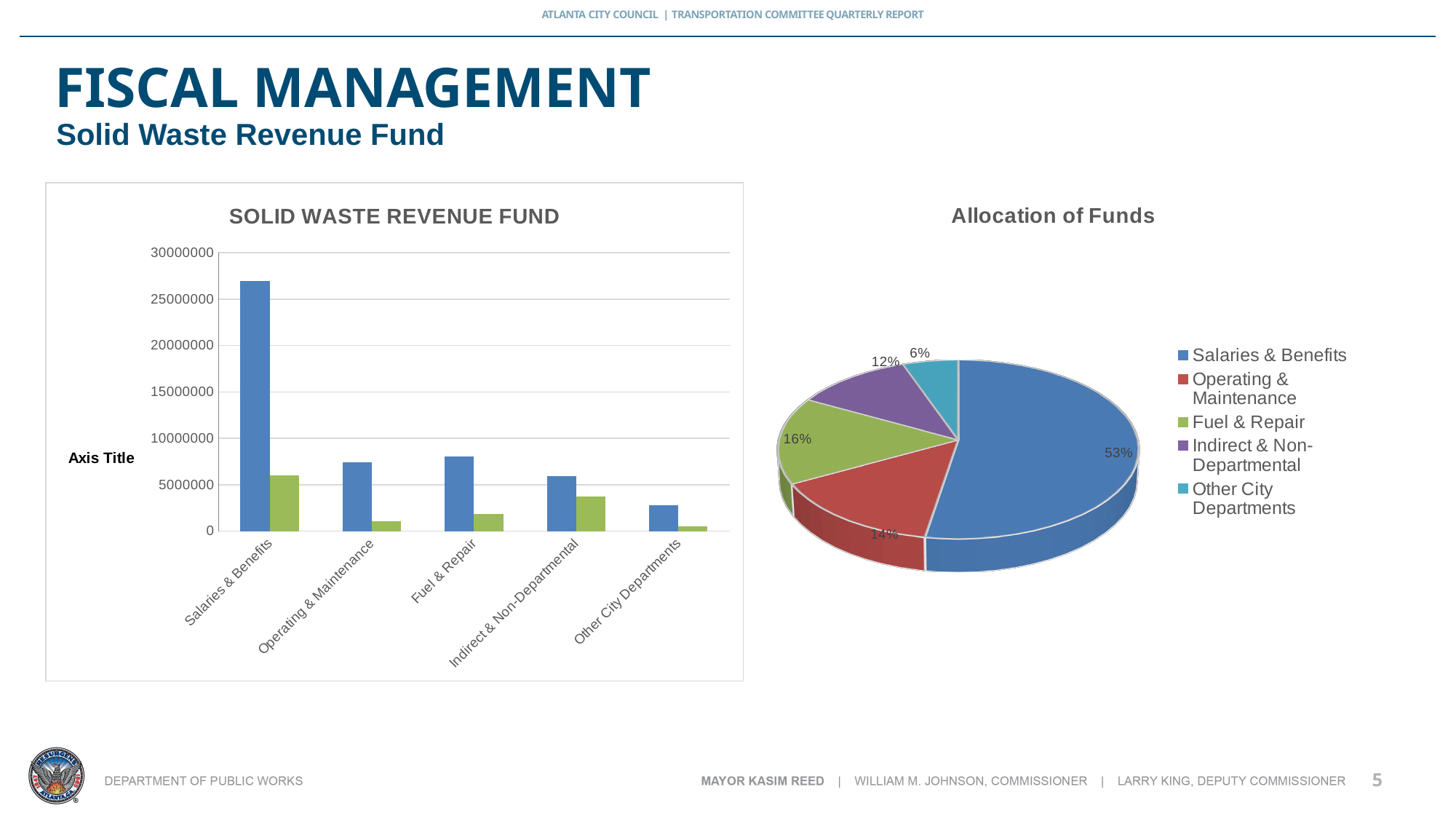
In the SOLID WASTE REVENUE FUND bar chart, is the blue bar for Other City Departments greater or less than 5000000? less How many entries does the legend of the Allocation of Funds pie chart list? 5 How many categories are shown on the x axis of the SOLID WASTE REVENUE FUND bar chart? 5 What kind of chart is the SOLID WASTE REVENUE FUND chart on the left? Bar chart In the SOLID WASTE REVENUE FUND bar chart, which category has the tallest blue bar? Salaries & Benefits In the Allocation of Funds pie chart, what share is Salaries & Benefits? 53% In the Allocation of Funds pie chart, which category has the smallest share? Other City Departments In the SOLID WASTE REVENUE FUND bar chart, is the blue bar for Salaries & Benefits greater or less than 25000000? greater In the Allocation of Funds pie chart, how many percentage points larger is Salaries & Benefits than Operating & Maintenance? 39 percentage points In the Allocation of Funds pie chart, what share is Other City Departments? 6% In the Allocation of Funds pie chart, which is larger: Fuel & Repair or Operating & Maintenance? Fuel & Repair In the Allocation of Funds pie chart, what share is Fuel & Repair? 16%